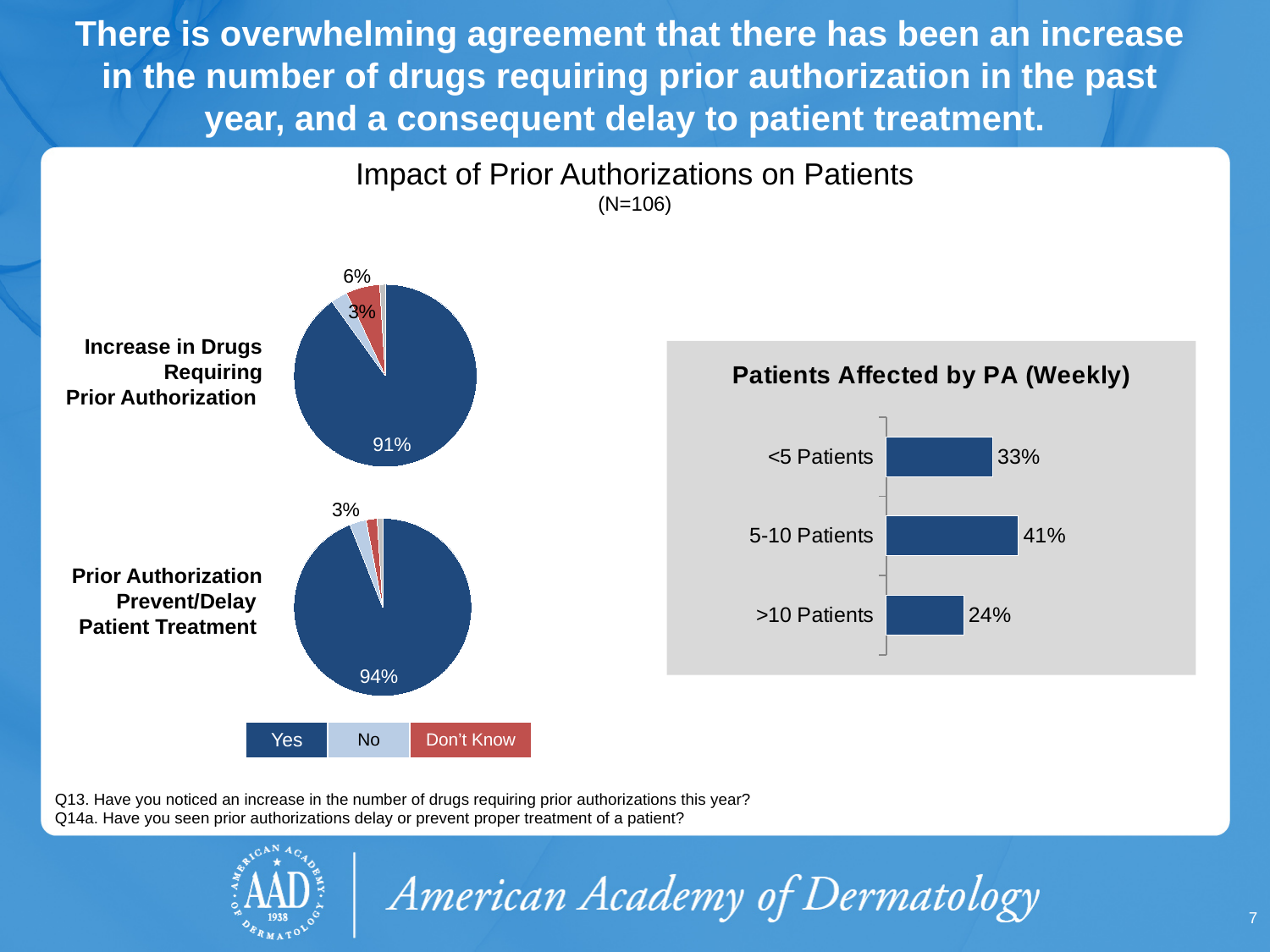
In the 'Patients Affected by PA (Weekly)' bar chart, what is the value for >10 Patients? 24% In the 'Patients Affected by PA (Weekly)' bar chart, what is the difference between the values for 5-10 Patients and >10 Patients? 17 percentage points How many categories are shown in the 'Patients Affected by PA (Weekly)' chart? 3 In the 'Patients Affected by PA (Weekly)' bar chart, which category has the highest value? 5-10 Patients In the 'Patients Affected by PA (Weekly)' bar chart, which category has the lowest value? >10 Patients In the 'Patients Affected by PA (Weekly)' bar chart, what is the value for <5 Patients? 33% In the 'Increase in Drugs Requiring Prior Authorization' pie chart, what percentage answered Yes? 91% In the 'Patients Affected by PA (Weekly)' bar chart, what is the value for 5-10 Patients? 41% How many entries does the legend below the pie charts list? 3 What kind of chart is 'Patients Affected by PA (Weekly)'? Bar chart In the 'Patients Affected by PA (Weekly)' bar chart, which is larger: the value for <5 Patients or for >10 Patients? <5 Patients In the 'Prior Authorization Prevent/Delay Patient Treatment' pie chart, what percentage answered Yes? 94%